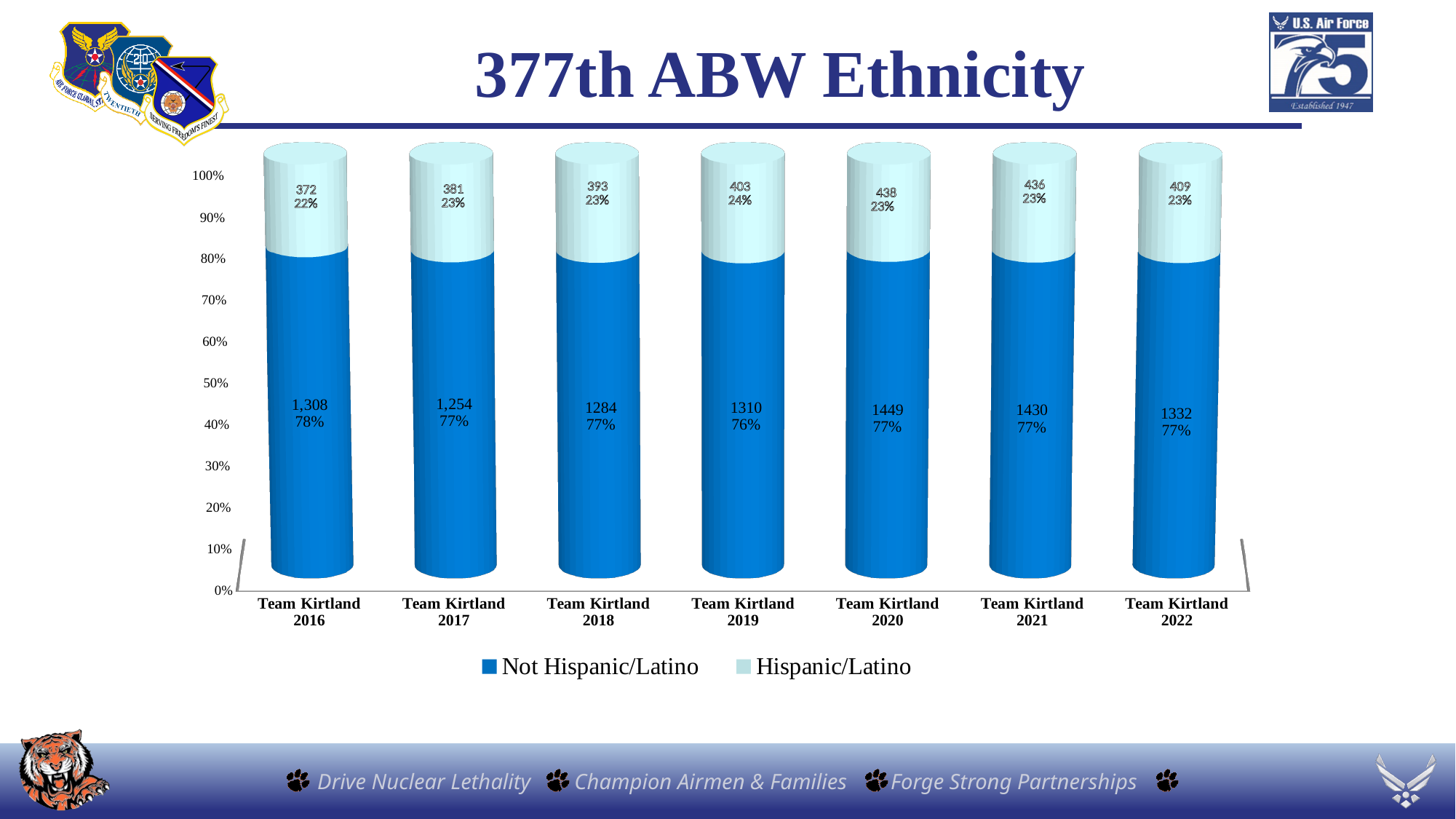
How many year categories are shown on the x axis? 7 What is the title of the chart? 377th ABW Ethnicity What is the difference between the Not Hispanic/Latino counts for Team Kirtland 2020 and Team Kirtland 2021? 19 Which year has the highest Not Hispanic/Latino count? Team Kirtland 2020 What is the Hispanic/Latino count for Team Kirtland 2020? 438 Which year has the lowest Hispanic/Latino count? Team Kirtland 2016 What percentage of Team Kirtland 2019 is Hispanic/Latino? 24% What is the Not Hispanic/Latino count for Team Kirtland 2016? 1,308 Which has the larger Hispanic/Latino count, Team Kirtland 2021 or Team Kirtland 2022? Team Kirtland 2021 What is the total count (Not Hispanic/Latino plus Hispanic/Latino) for Team Kirtland 2016? 1,680 How many series does the legend list? 2 What kind of chart is shown on the slide? Stacked bar chart